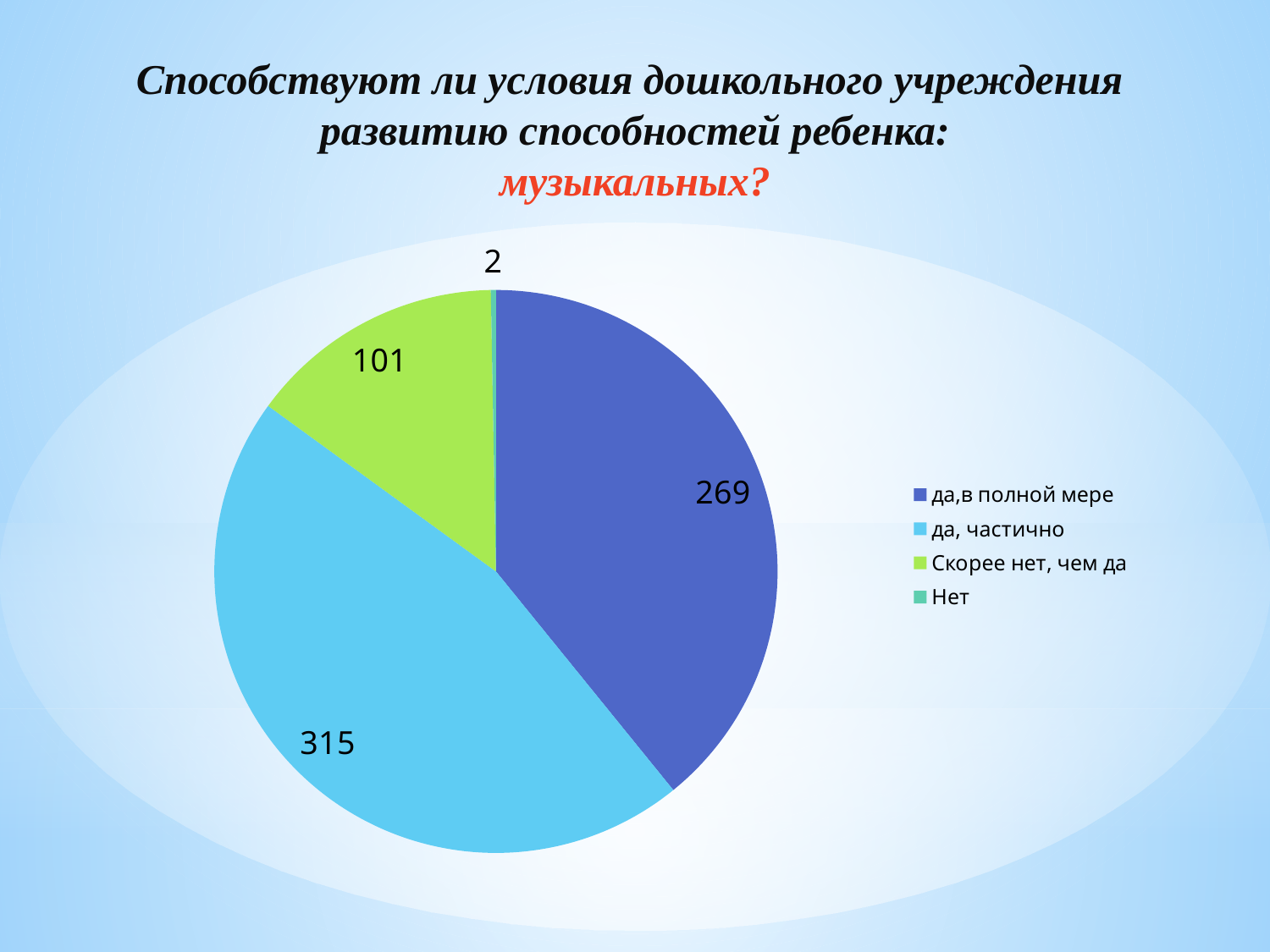
What is the total of all the values shown in the pie chart? 687 What is the difference between the values for "да,в полной мере" and "Скорее нет, чем да"? 168 What is the value for "да,в полной мере"? 269 What is the value for "Скорее нет, чем да"? 101 Which category has the smallest slice of the pie? Нет Which is larger, the value for "Скорее нет, чем да" or the value for "Нет"? Скорее нет, чем да What is the value for "да, частично"? 315 How many categories does the pie chart have? 4 What kind of chart is shown on the slide? pie chart What is the difference between the values for "да, частично" and "да,в полной мере"? 46 What is the value for "Нет"? 2 Which category has the largest slice of the pie? да, частично